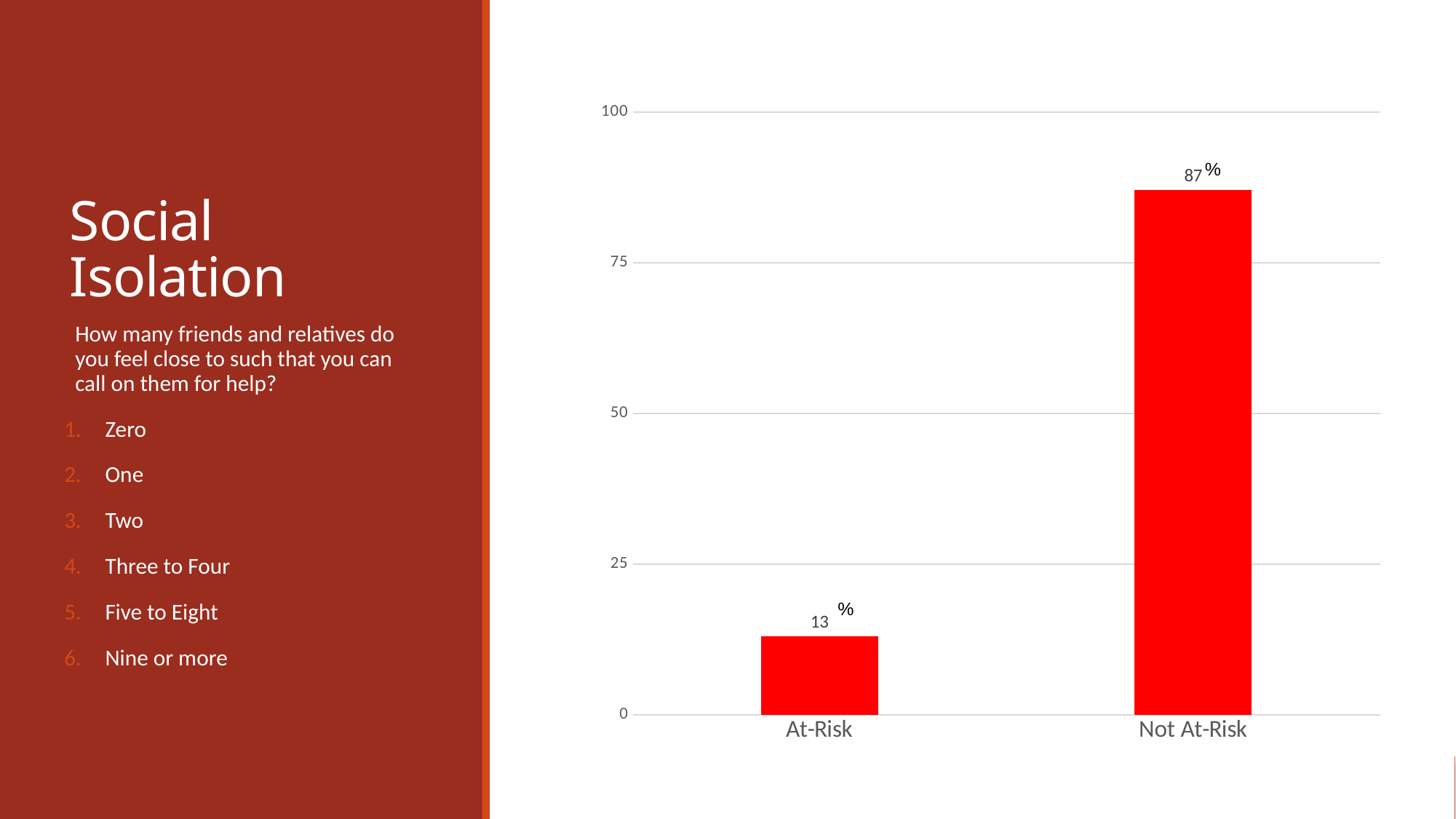
What kind of chart is shown on the slide? bar chart Which is larger, the value for At-Risk or the value for Not At-Risk? Not At-Risk What is the difference between the values for Not At-Risk and At-Risk? 74% What is the value for Not At-Risk? 87% Is the value for Not At-Risk greater or less than 75? greater How many categories are shown on the x axis? 2 Which category has the highest value? Not At-Risk What is the total of the two bar values? 100% What is the value for At-Risk? 13% Which category has the lowest value? At-Risk What colour are the bars in the chart? red Is the value for At-Risk greater or less than 25? less